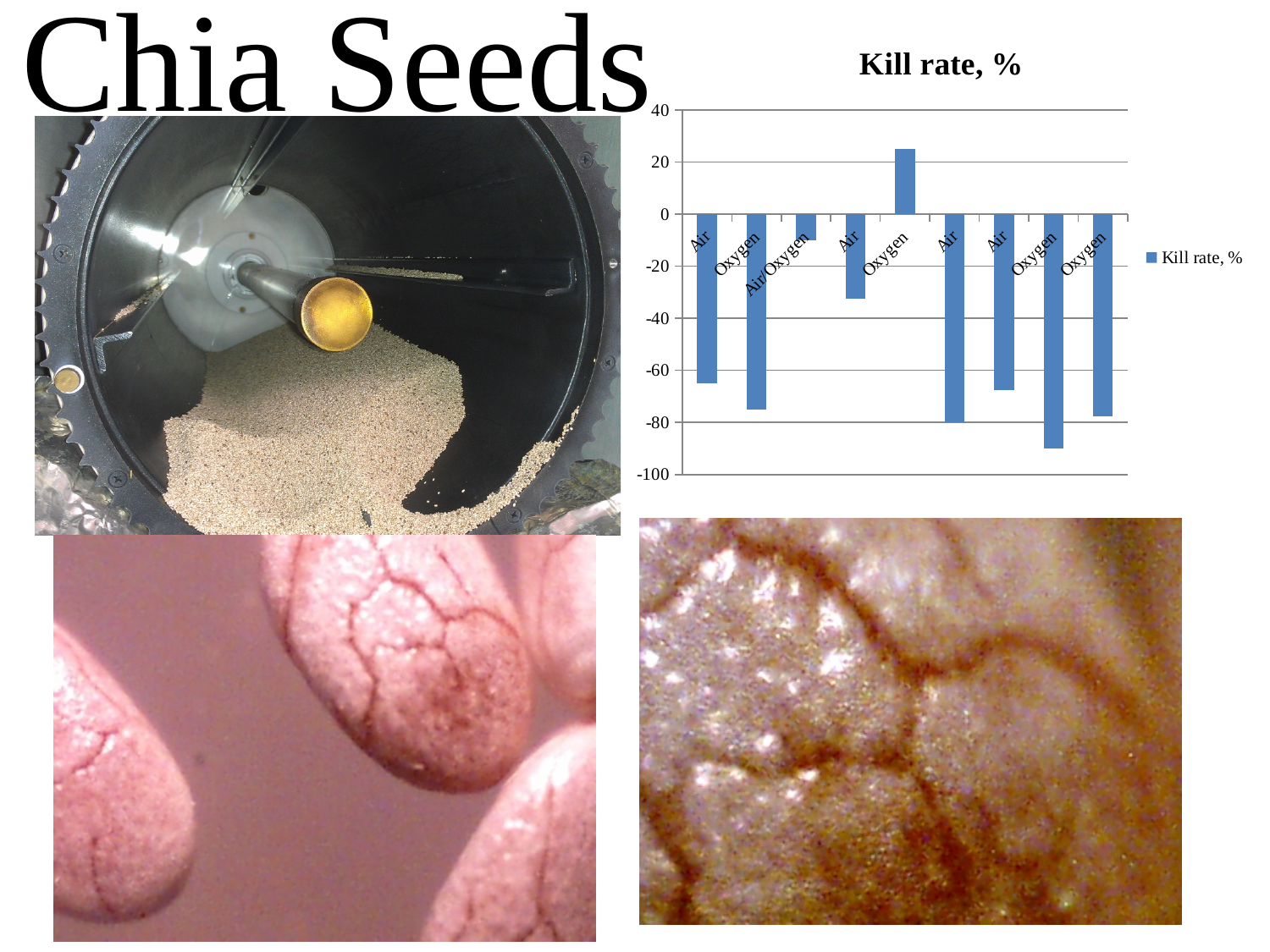
In the Kill rate, % chart, is the value for the Air/Oxygen bar greater or less than -20? greater In the Kill rate, % chart, which has the larger value: the first bar (Air) or the third bar (Air/Oxygen)? Air/Oxygen In the Kill rate, % chart, is the value for the first bar (Air) greater or less than -60? less What is the title of the chart on the slide? Kill rate, % What colour are the bars in the Kill rate, % chart? blue How many bars are plotted in the Kill rate, % chart? 9 What kind of chart is shown on the slide? bar chart In the Kill rate, % chart, is the value for the fifth bar (Oxygen) greater or less than 0? greater In the Kill rate, % chart, which bar has the lowest value? the eighth bar, Oxygen How many series does the legend of the Kill rate, % chart list? 1 In the Kill rate, % chart, which bar has the highest value? the fifth bar, Oxygen